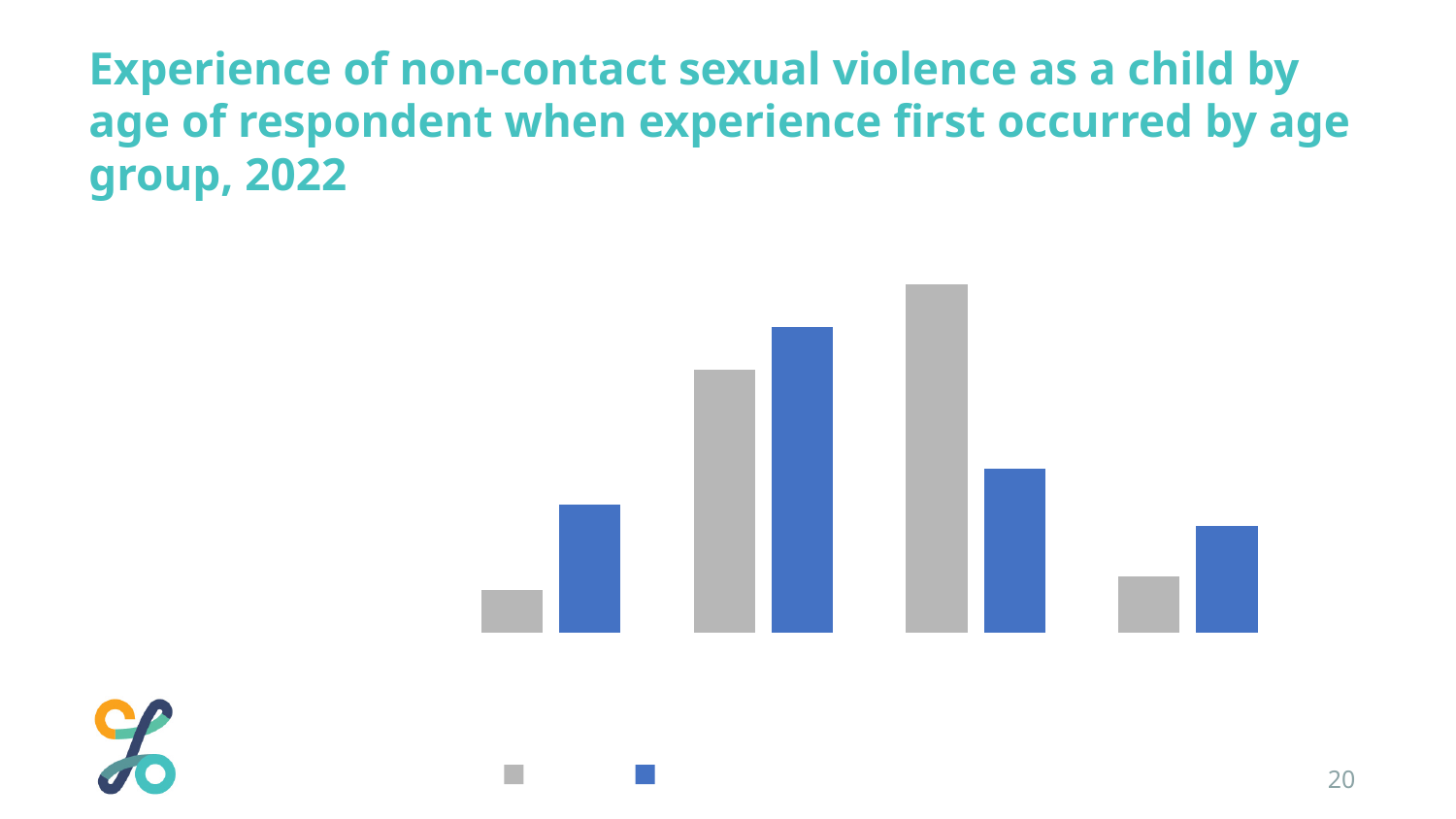
What two colours are used for the bars in the chart? grey and blue What kind of chart is shown on the slide? bar chart How many series does the legend list? 2 In the first group of bars from the left, which bar is taller, the grey one or the blue one? blue Which group of bars from the left contains the tallest bar in the chart? third In the third group of bars from the left, which bar is taller, the grey one or the blue one? grey How many groups of bars are plotted in the chart? 4 Which group of bars from the left contains the shortest bar in the chart? first What year is given in the chart title? 2022